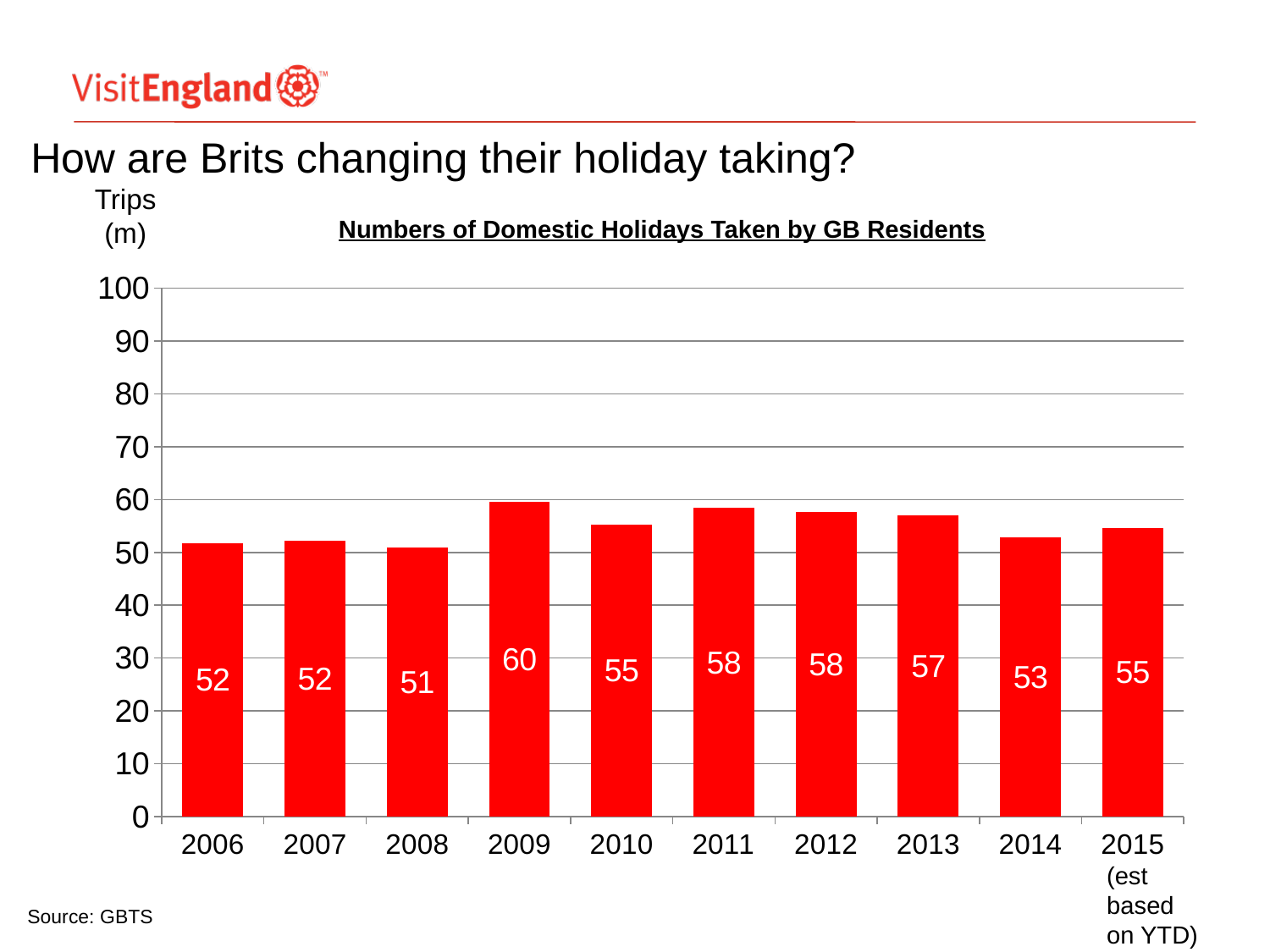
Which is larger, the value for 2013 or the value for 2014? 2013 Which year has the highest number of domestic holidays? 2009 What is the label on the y axis? Trips (m) Is the value for 2011 greater or less than 50? greater What is the title of the chart? Numbers of Domestic Holidays Taken by GB Residents What is the value for 2009? 60 Which year has the lowest number of domestic holidays? 2008 What is the value for 2014? 53 What is the value for 2015 (est based on YTD)? 55 What is the difference between the values for 2009 and 2008? 9 How many years are shown on the x axis? 10 What kind of chart is shown on the slide? bar chart